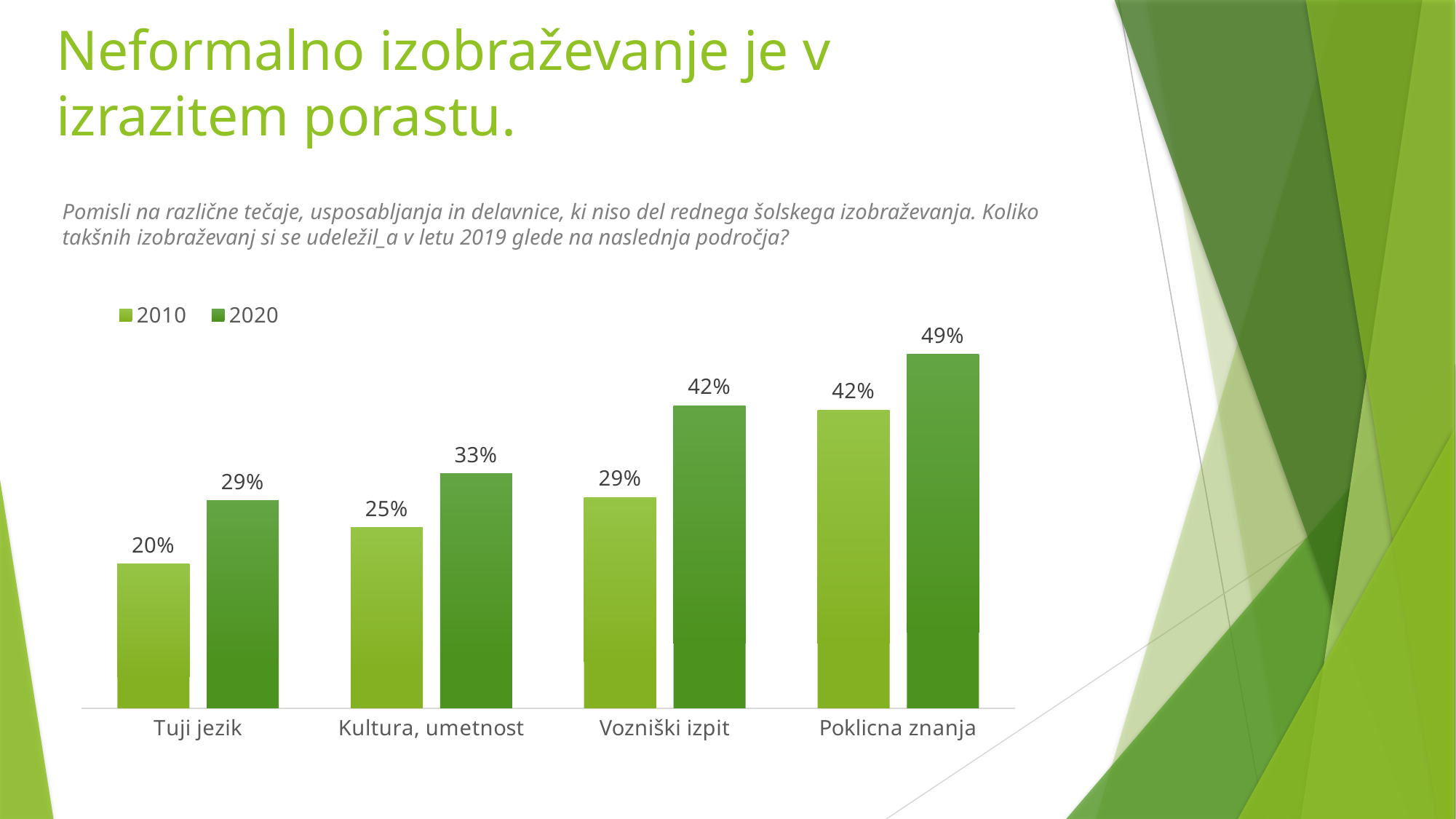
What kind of chart is shown on the slide? Bar chart What is the difference between the 2020 and 2010 values for Vozniški izpit? 13% What is the 2010 value for Vozniški izpit? 29% Which category has the lowest 2010 value? Tuji jezik Which is larger: the 2010 value for Poklicna znanja or the 2020 value for Kultura, umetnost? 2010 value for Poklicna znanja How many categories are shown on the x axis? 4 What is the 2010 value for Tuji jezik? 20% What is the difference between the 2020 values for Poklicna znanja and Tuji jezik? 20% What is the 2020 value for Poklicna znanja? 49% What is the 2020 value for Kultura, umetnost? 33% Which category has the highest 2020 value? Poklicna znanja How many series does the legend list? 2